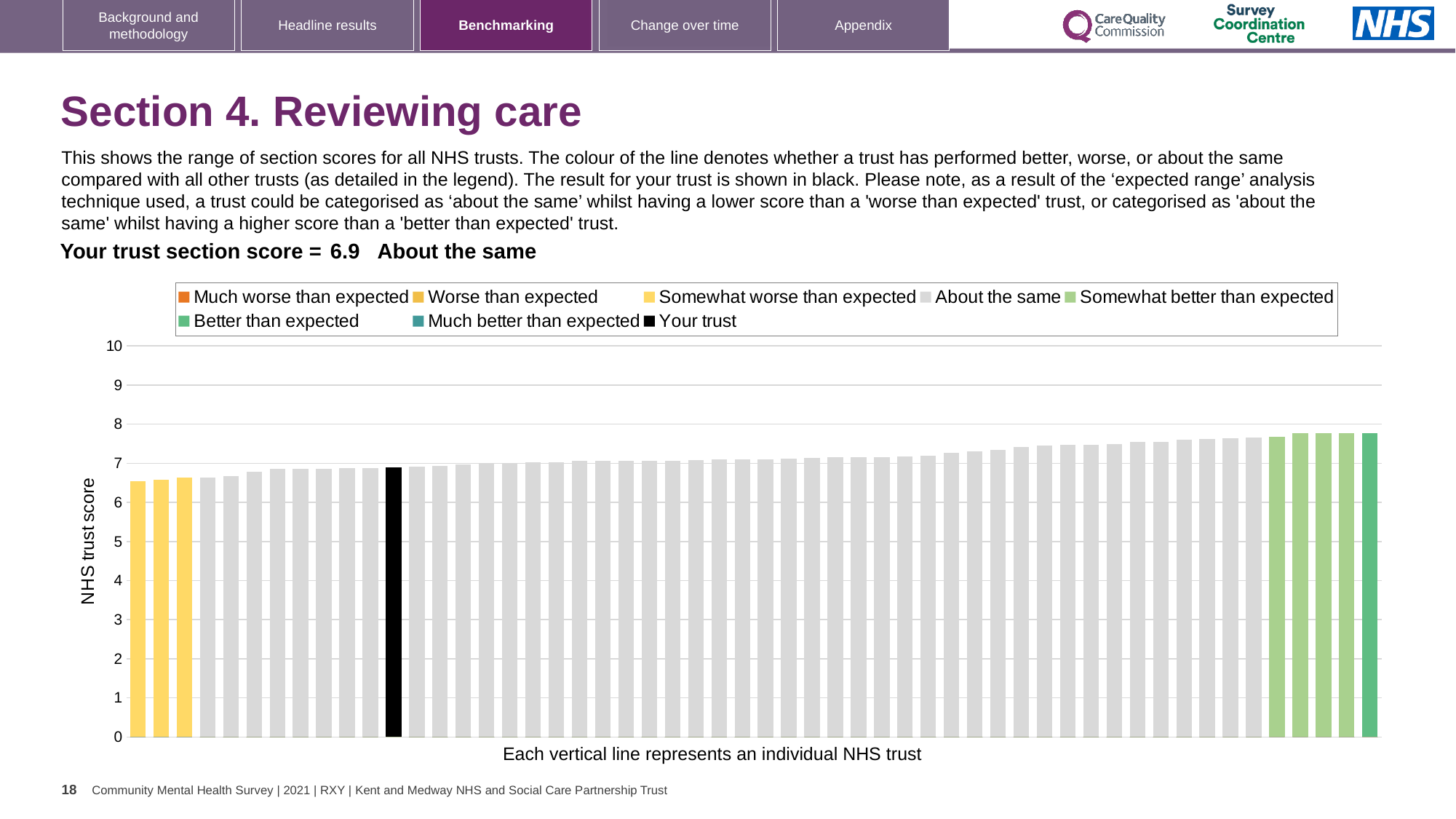
Which is larger: the black 'Your trust' bar or the leftmost yellow bar? the black 'Your trust' bar Which performance category is the trust's section score assigned to? About the same Do the bar values rise or fall from left to right along the x axis? rise How many bars are coloured yellow ('Somewhat worse than expected')? 3 Is the shortest bar in the chart greater or less than 6? greater How many entries does the chart legend list? 8 What type of chart is shown on the slide? bar chart What is the label on the vertical axis of the chart? NHS trust score What is the trust's section score for Section 4, Reviewing care? 6.9 Is the value of the black 'Your trust' bar greater or less than 8? less Is the value of the black 'Your trust' bar greater or less than 6? greater